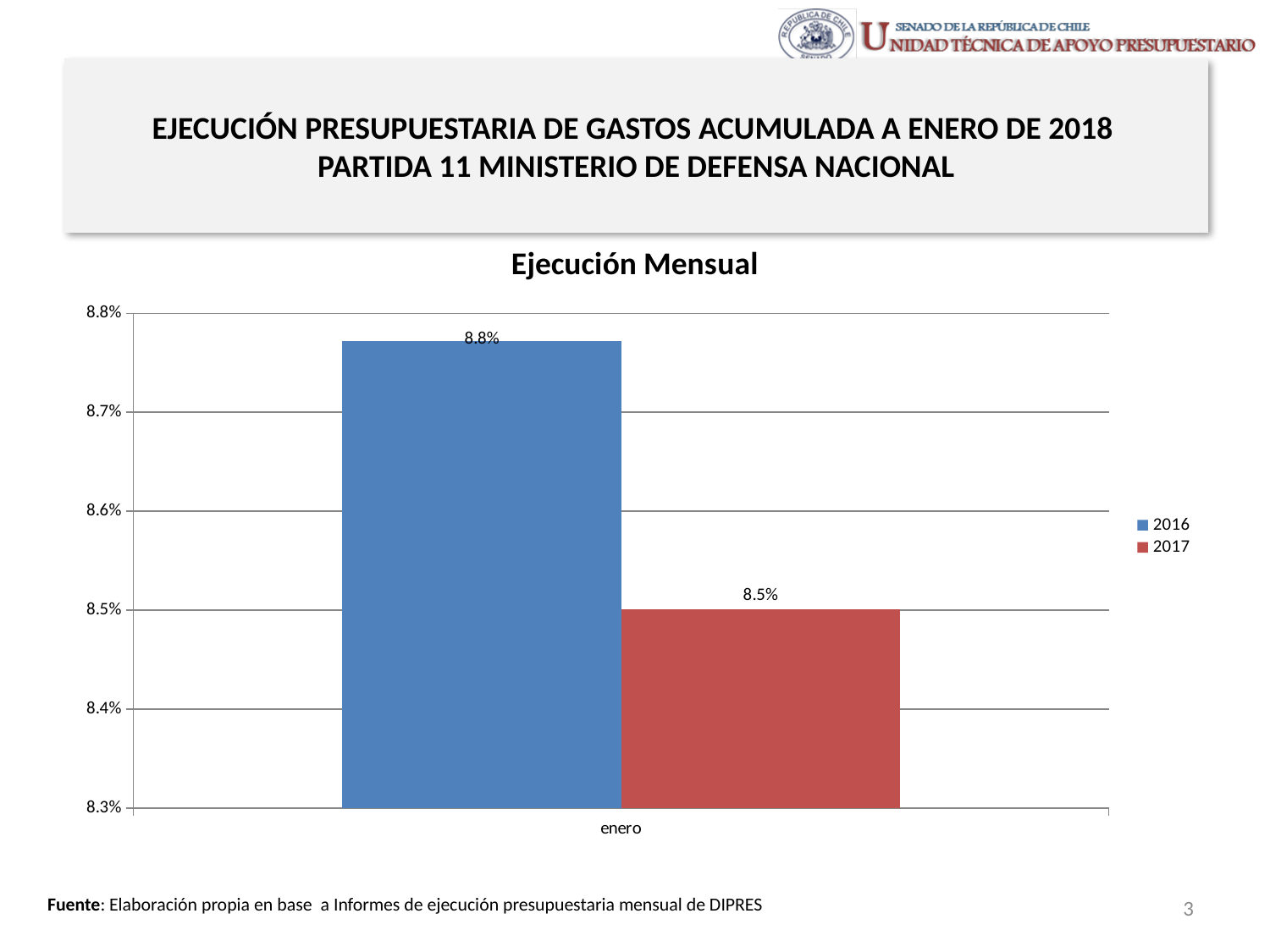
How many series does the legend list? 2 What is the value for 2016 in the Ejecución Mensual chart? 8.8% What is the value for 2017 in the Ejecución Mensual chart? 8.5% What is the difference between the 2016 and 2017 values for enero? 0.3% Which series shows the lowest value in the chart? 2017 Is the value for 2017 greater or less than 8.6%? less Which category label appears on the x axis? enero What is the title of the chart? Ejecución Mensual Which series has the higher value for enero, 2016 or 2017? 2016 Is the value for 2016 greater or less than 8.7%? greater What kind of chart is shown on the slide? bar chart How many categories are shown on the x axis? 1